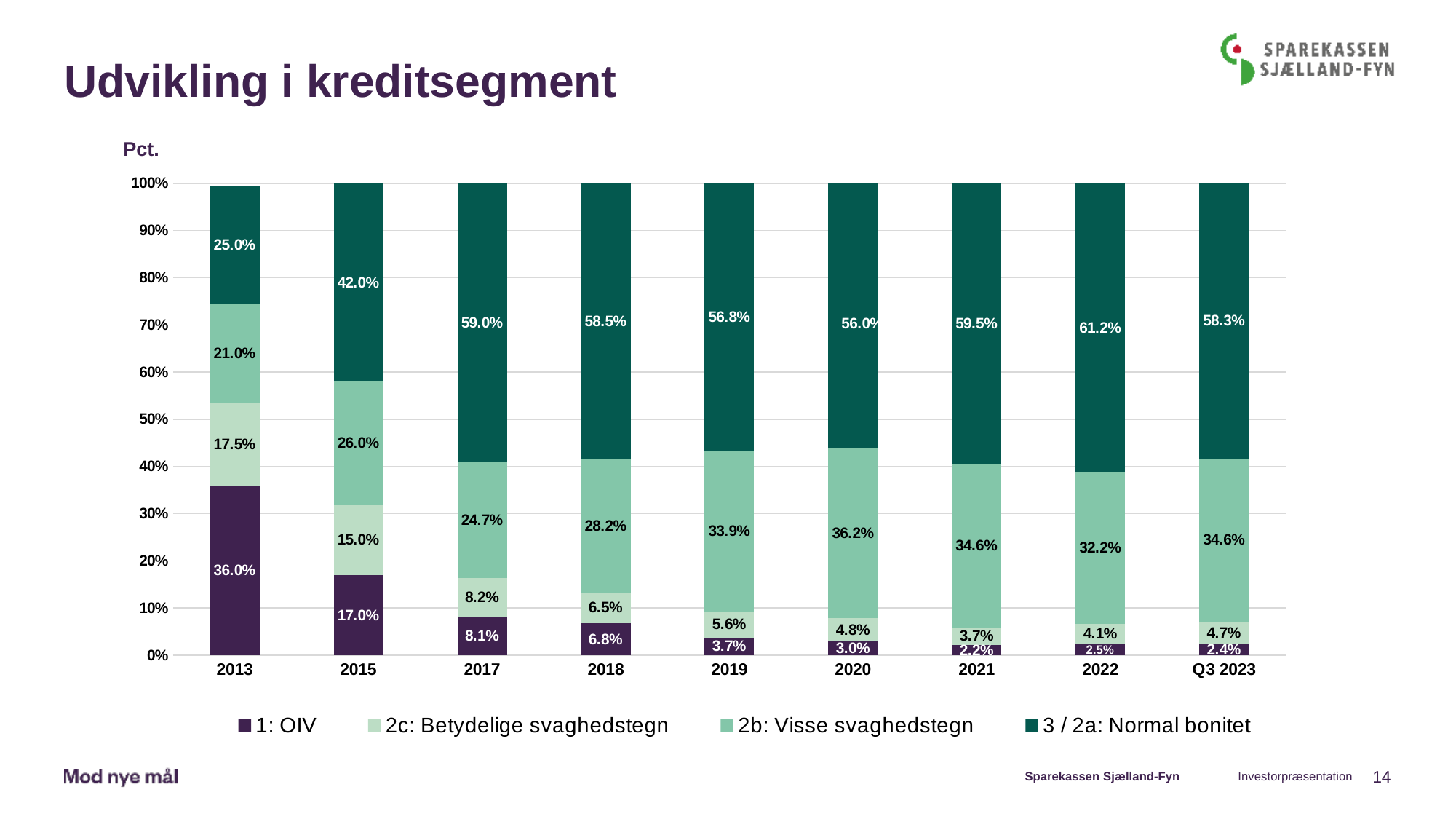
What is the value for 2c: Betydelige svaghedstegn in 2019? 5.6% Which year has the highest value for 1: OIV? 2013 How many periods are shown on the x axis? 9 What kind of chart is shown on the slide? Stacked bar chart Does the value for 1: OIV rise or fall from 2013 to Q3 2023? Fall What is the value for 3 / 2a: Normal bonitet in 2022? 61.2% What is the value for 1: OIV in 2013? 36.0% Which year has the highest value for 3 / 2a: Normal bonitet? 2022 How many series does the legend list? 4 Which year has the lowest value for 1: OIV? 2021 Which is larger, the 3 / 2a: Normal bonitet value in 2017 or in 2018? 2017 What is the difference between the 2b: Visse svaghedstegn value in 2020 and in 2013? 15.2 percentage points